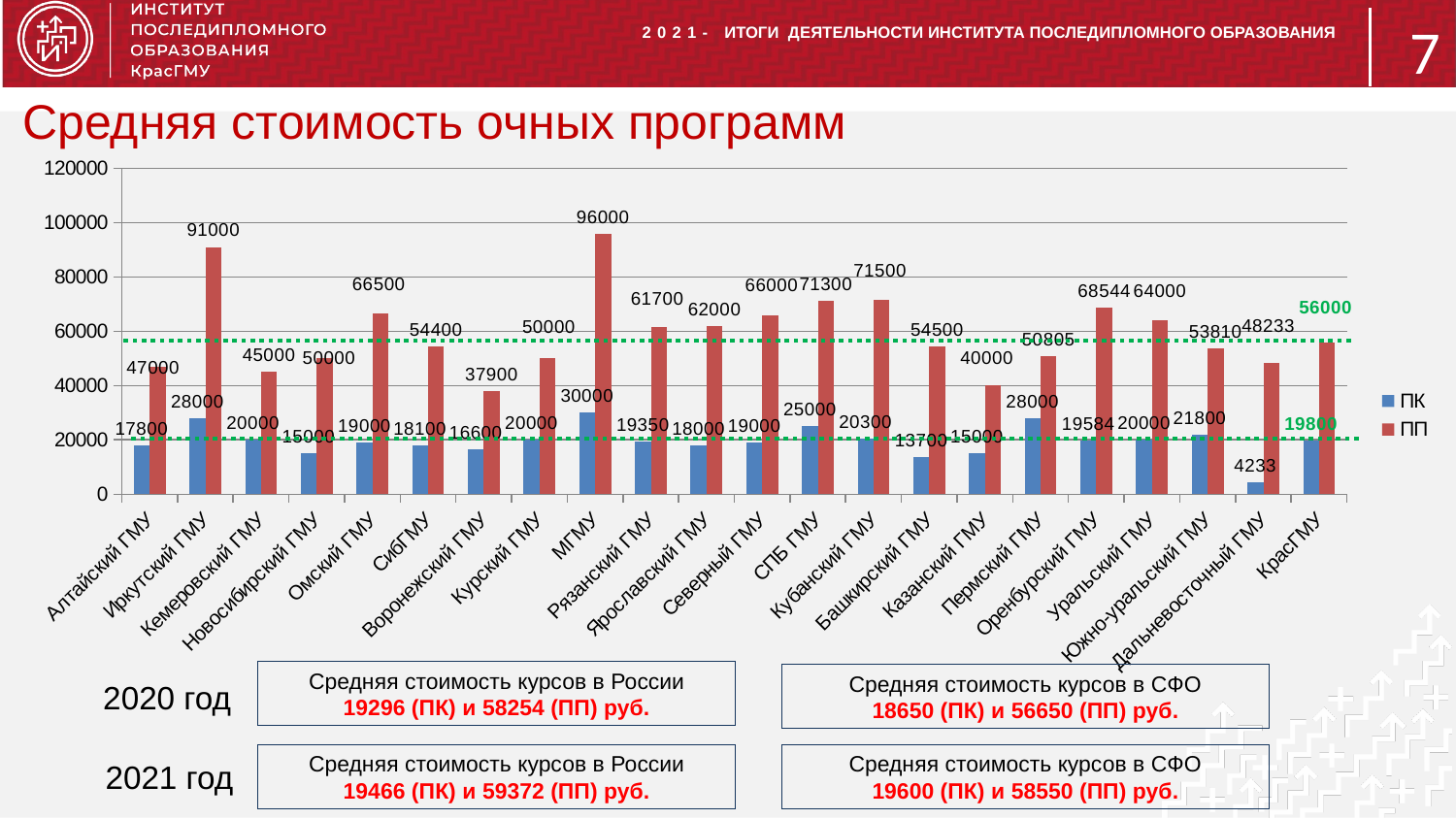
What is the ПП value for МГМУ? 96000 Which university has the lowest ПП value? Воронежский ГМУ How many universities (categories) are shown on the x axis? 22 What type of chart is shown on the slide? bar chart Which university has the highest ПП value? МГМУ What is the ПК value for КрасГМУ? 19800 Which university has the lowest ПК value? Дальневосточный ГМУ How many series does the legend list? 2 What is the difference between the ПП values of Иркутский ГМУ and Алтайский ГМУ? 44000 Which is larger: the ПК value for Пермский ГМУ or the ПК value for СПБ ГМУ? Пермский ГМУ What is the title of the chart? Средняя стоимость очных программ What is the ПП value for Иркутский ГМУ? 91000